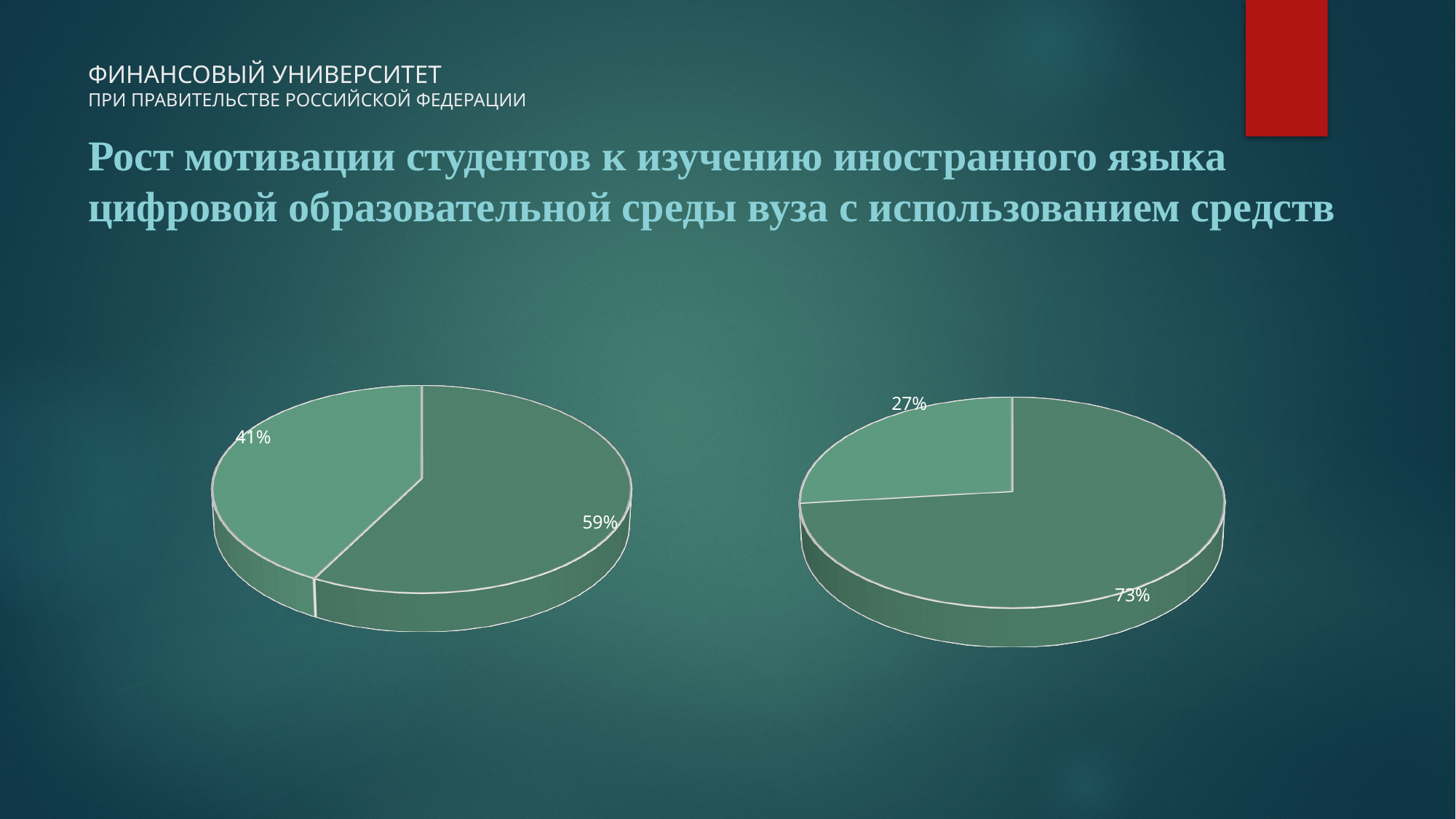
In the left pie chart, what is the difference between the two slices? 18% In the left pie chart, how many slices are there? 2 In the right pie chart, what is the difference between the two slices? 46% Which is larger: the largest slice of the left pie chart or the largest slice of the right pie chart? the largest slice of the right pie chart In the left pie chart, what is the value of the largest slice? 59% In the right pie chart, how many slices are there? 2 What kind of chart is the chart on the left of the slide? pie chart What kind of chart is the chart on the right of the slide? pie chart In the right pie chart, what is the value of the largest slice? 73% How many pie charts are shown on the slide? 2 In the right pie chart, what is the value of the smallest slice? 27% In the left pie chart, what is the value of the smallest slice? 41%